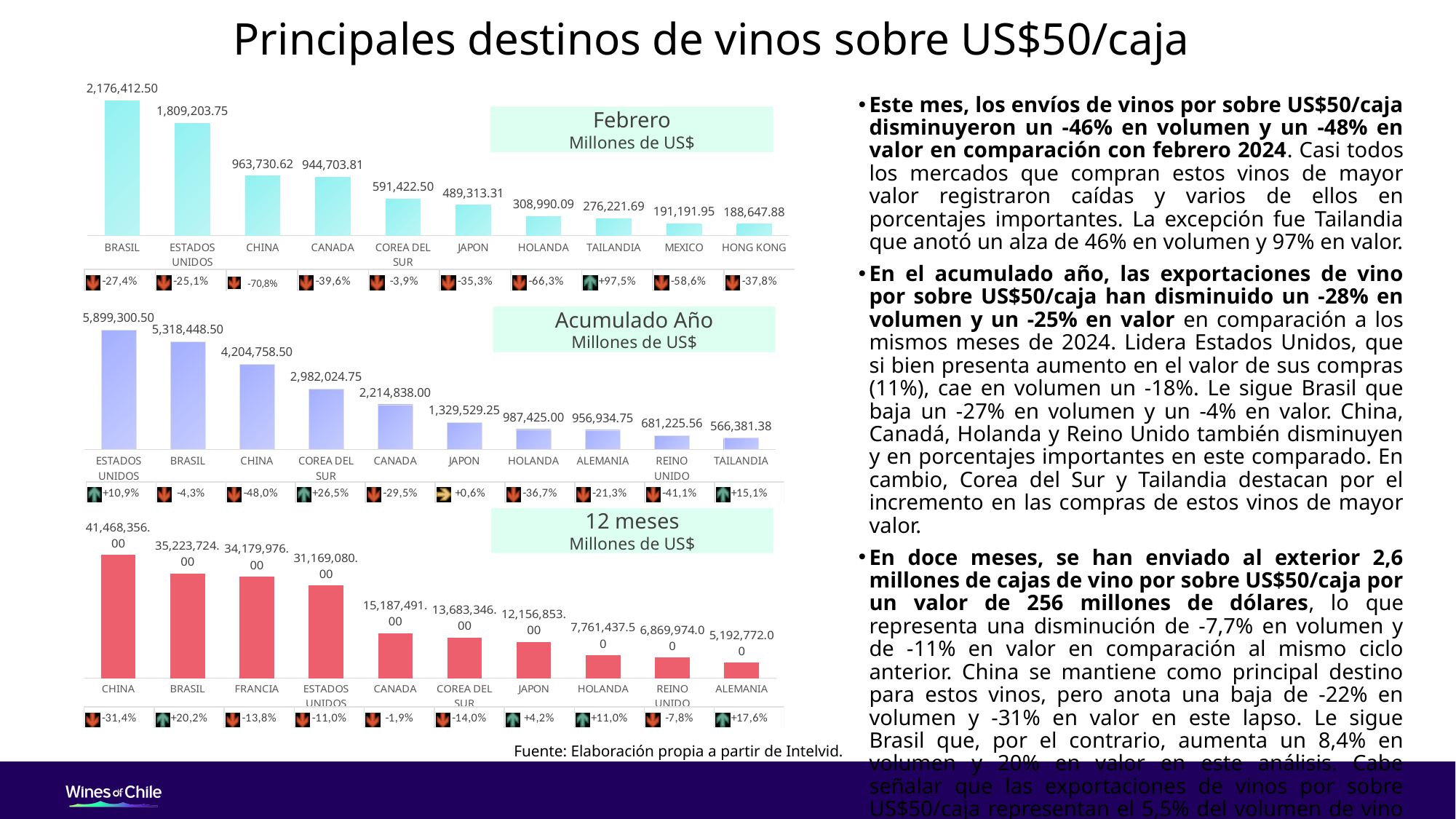
In the 12 meses chart, what is the value for FRANCIA? 34,179,976.00 In the Acumulado Año chart, which is larger, the value for HOLANDA or the value for REINO UNIDO? HOLANDA In the Febrero chart, what is the difference between the values for BRASIL and ESTADOS UNIDOS? 367,208.75 In the Acumulado Año chart, what is the value for COREA DEL SUR? 2,982,024.75 In the Febrero chart, which destination has the lowest value? HONG KONG In the Febrero chart, what is the value for BRASIL? 2,176,412.50 In the 12 meses chart, what is the difference between the values for CHINA and BRASIL? 6,244,632.00 In the Febrero chart, do the values rise or fall from left to right along the x axis? Fall In the Acumulado Año chart, which destination has the highest value? ESTADOS UNIDOS What kind of chart is the 12 meses chart? Bar chart In the 12 meses chart, which destination has the highest value? CHINA In the Acumulado Año chart, how many destinations are shown? 10